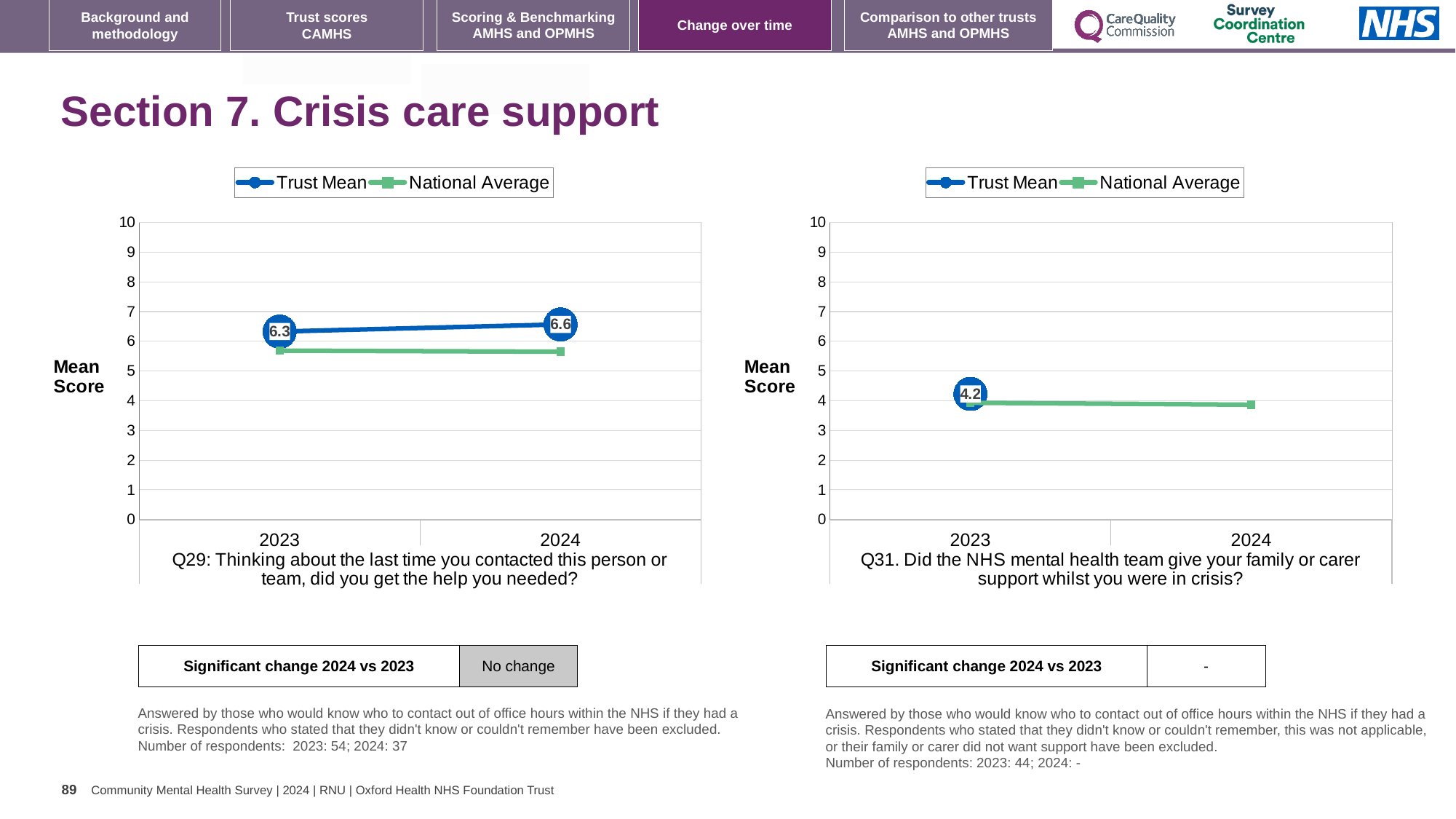
On the Q29 chart (left), is the National Average for 2023 greater or less than 6? less How many series does the legend of the Q31 chart (right) list? 2 On the Q31 chart (right), what is the Trust Mean score for 2023? 4.2 On the Q29 chart (left), by how much did the Trust Mean change from 2023 to 2024? 0.3 On the Q29 chart (left), what is the Trust Mean score for 2023? 6.3 On the Q29 chart (left), what is the Trust Mean score for 2024? 6.6 On the Q29 chart (left), does the Trust Mean rise or fall from 2023 to 2024? rise On the Q31 chart (right), is the National Average for 2024 greater or less than 5? less How many years are shown on the x axis of the Q31 chart (right)? 2 What type of chart is the Q29 chart (left)? line chart On the Q29 chart (left), which year has the higher Trust Mean, 2023 or 2024? 2024 On the Q29 chart (left), in 2024 which series is higher, Trust Mean or National Average? Trust Mean